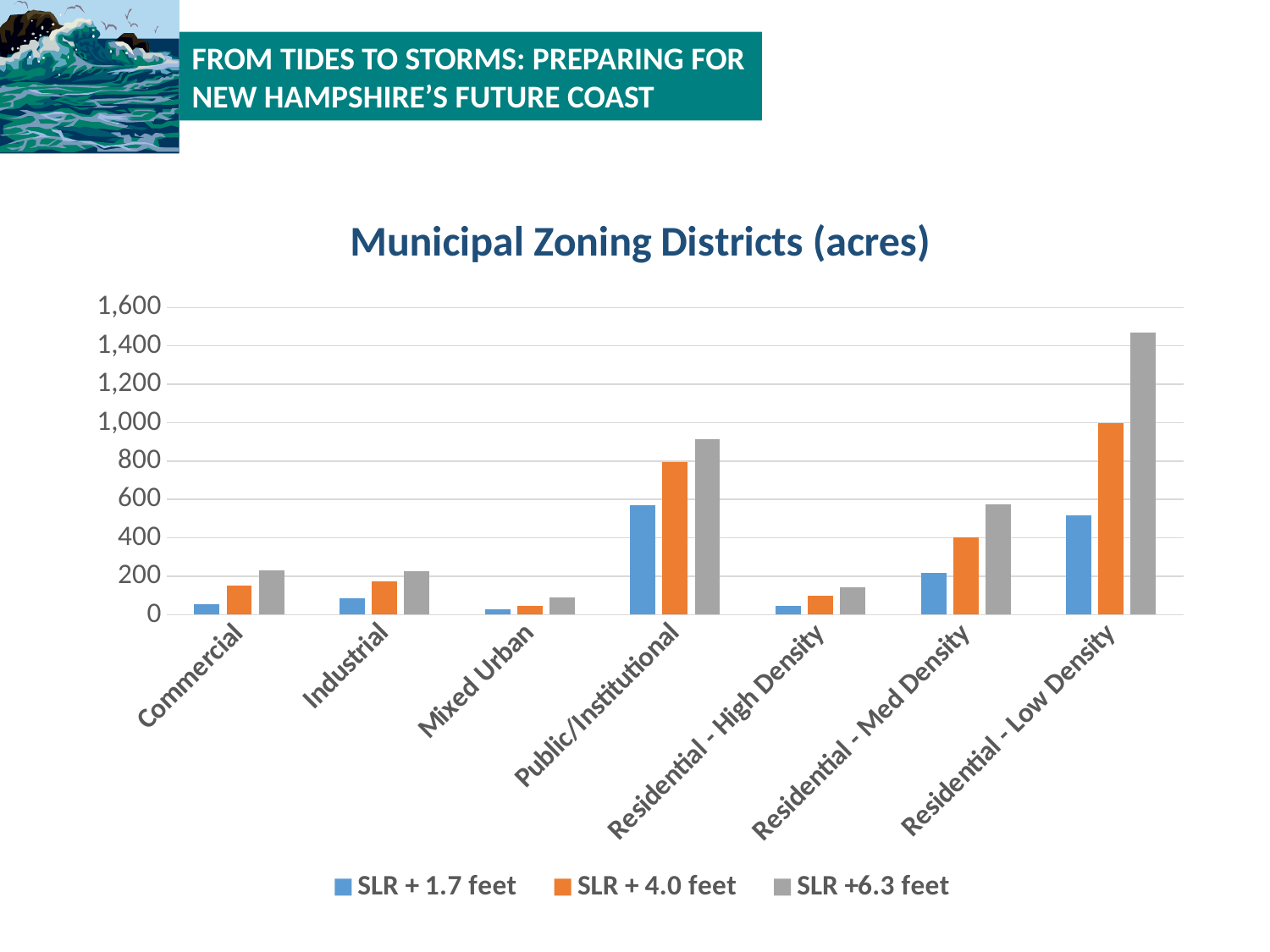
Which zoning district has the highest value for SLR +6.3 feet? Residential - Low Density Is the SLR +6.3 feet value for Residential - Low Density greater or less than 1,400? greater How many series does the legend list? 3 Which is larger: the SLR + 4.0 feet value for Public/Institutional or the SLR +6.3 feet value for Residential - Med Density? SLR + 4.0 feet value for Public/Institutional How many zoning district categories are shown on the x axis? 7 Which colour represents the SLR + 4.0 feet series in the legend? Orange What type of chart is shown on the slide? Bar chart Is the SLR + 1.7 feet value for Residential - Med Density greater or less than 400? less Which zoning district has the lowest value for SLR +6.3 feet? Mixed Urban Is the SLR +6.3 feet value for Mixed Urban greater or less than 200? less What is the title of the chart? Municipal Zoning Districts (acres)